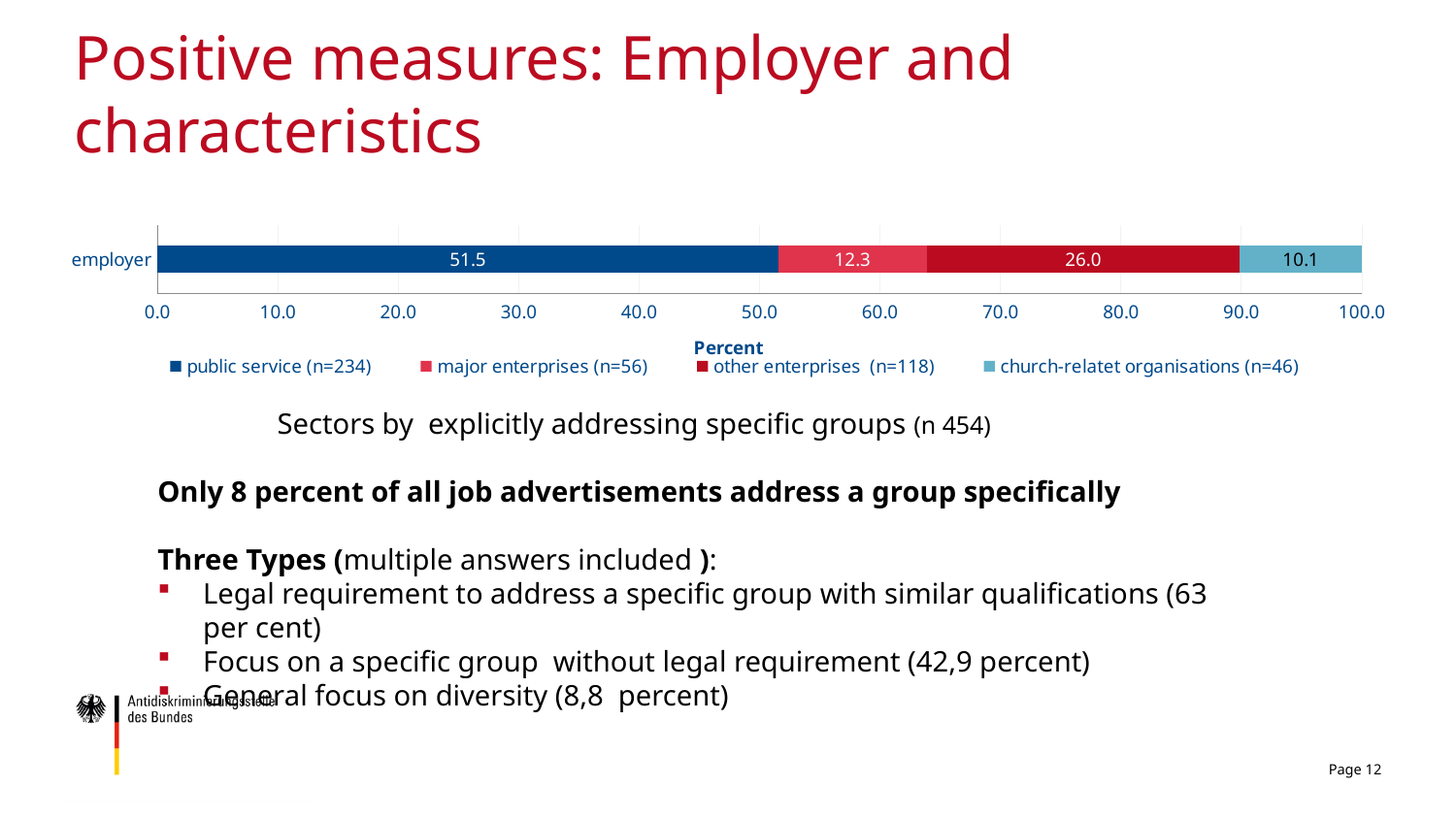
Which series has the smallest segment in the employer bar? church-relatet organisations (n=46) Which is larger, the value for major enterprises (n=56) or the value for other enterprises (n=118)? other enterprises (n=118) What kind of chart is shown on the slide? stacked bar chart What is the value for public service (n=234) in the employer bar? 51.5 What is the total of the employer stacked bar? 99.9 What is the value for church-relatet organisations (n=46) in the employer bar? 10.1 What is the label of the x axis? Percent What is the difference between the public service (n=234) value and the other enterprises (n=118) value? 25.5 Which series has the largest segment in the employer bar? public service (n=234) What is the value for other enterprises (n=118) in the employer bar? 26.0 What is the value for major enterprises (n=56) in the employer bar? 12.3 How many series does the legend list? 4